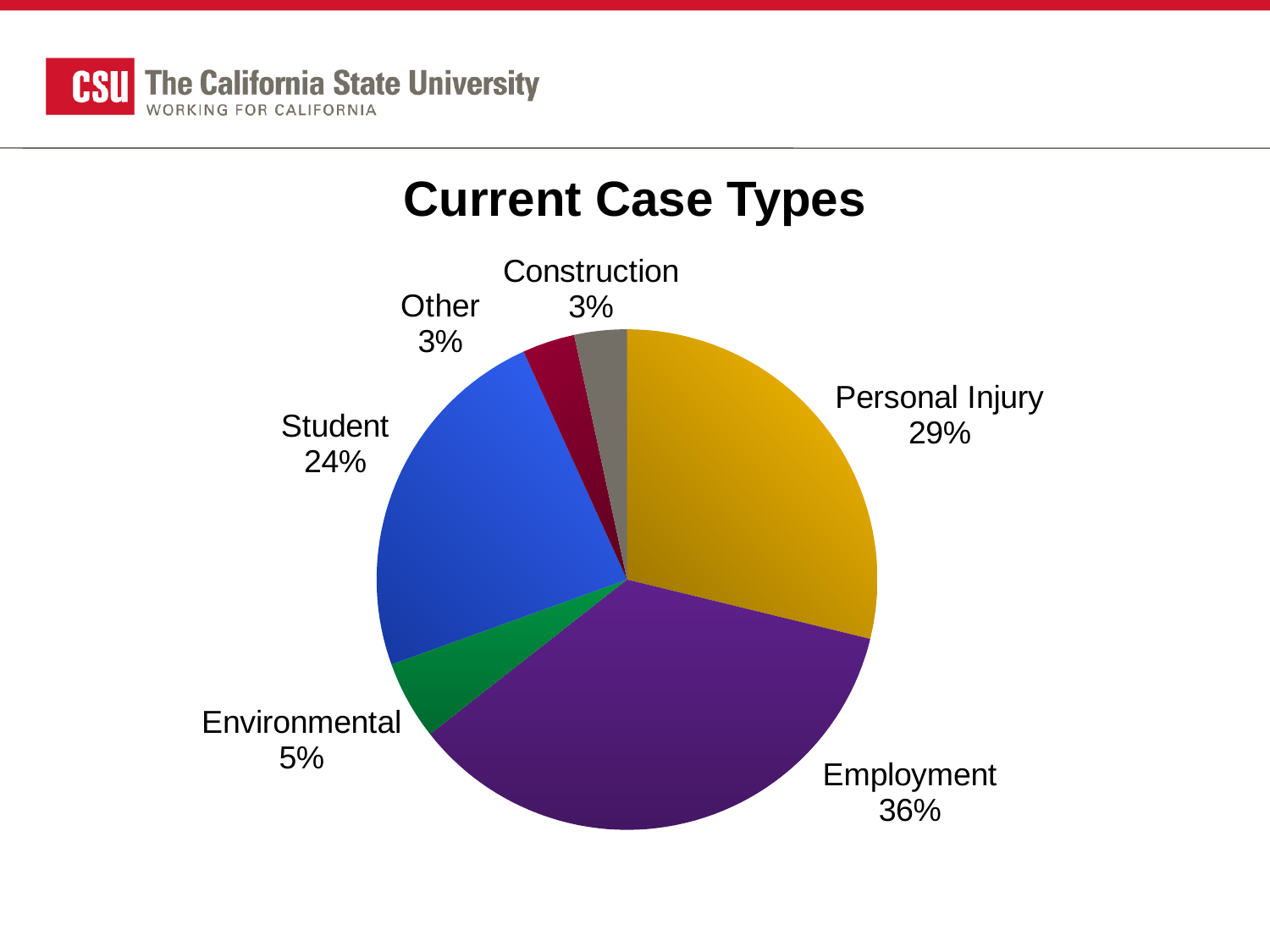
What is the title of the chart? Current Case Types What share of current case types is Employment? 36% What percentage of cases is Student? 24% Which is larger, the Student share or the Personal Injury share? Personal Injury What is the combined percentage of Construction and Other cases? 6% What percentage of cases is Personal Injury? 29% What percentage of cases is Environmental? 5% What kind of chart is shown on the slide? Pie chart Which case type has the largest share of the pie? Employment How many case type categories are shown in the pie chart? 6 What is the difference in percentage points between Employment and Personal Injury? 7